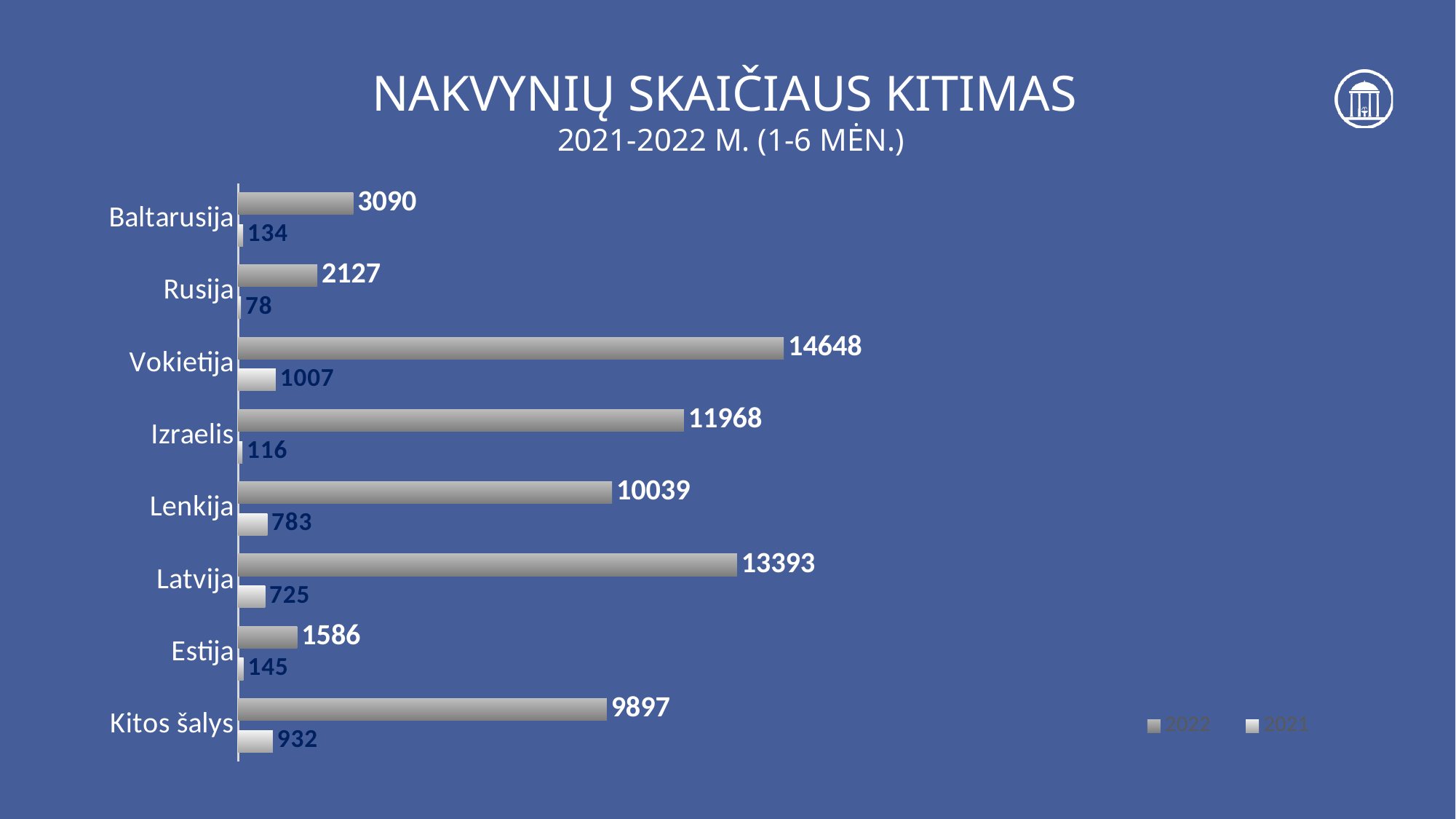
Which is larger, the 2022 value for Izraelis or the 2022 value for Lenkija? Izraelis What is the 2021 value for Lenkija? 783 How many categories are shown on the chart? 8 What is the 2021 value for Rusija? 78 What is the title of the chart? NAKVYNIŲ SKAIČIAUS KITIMAS 2021-2022 M. (1-6 MĖN.) Which category has the highest 2022 value? Vokietija Which category has the lowest 2021 value? Rusija How many series does the legend list? 2 What is the 2022 value for Vokietija? 14648 What is the difference between the 2022 and 2021 values for Latvija? 12668 What is the 2022 value for Kitos šalys? 9897 What kind of chart is shown on the slide? Bar chart